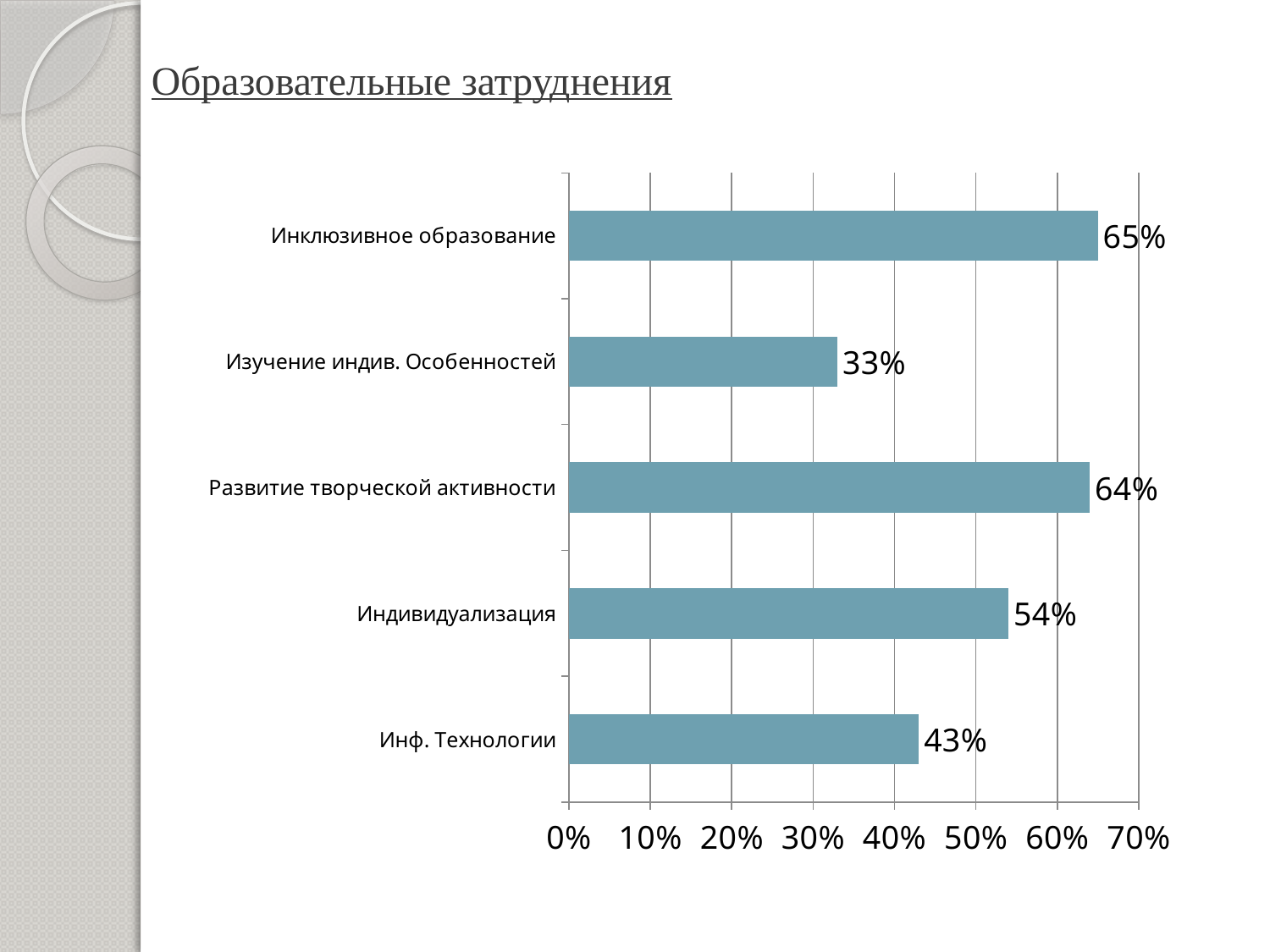
What kind of chart is shown on the slide? bar chart Which category has the lowest value? Изучение индив. Особенностей Is the value for Развитие творческой активности greater or less than 50%? greater What is the value for Изучение индив. Особенностей? 33% What is the difference between the values for Индивидуализация and Инф. Технологии? 11% What is the maximum value shown on the horizontal axis? 70% What is the title of the slide? Образовательные затруднения What is the value for Инф. Технологии? 43% What is the value for Инклюзивное образование? 65% What is the difference between the values for Инклюзивное образование and Изучение индив. Особенностей? 32% Which is larger, the value for Индивидуализация or the value for Инф. Технологии? Индивидуализация How many categories are shown in the chart? 5